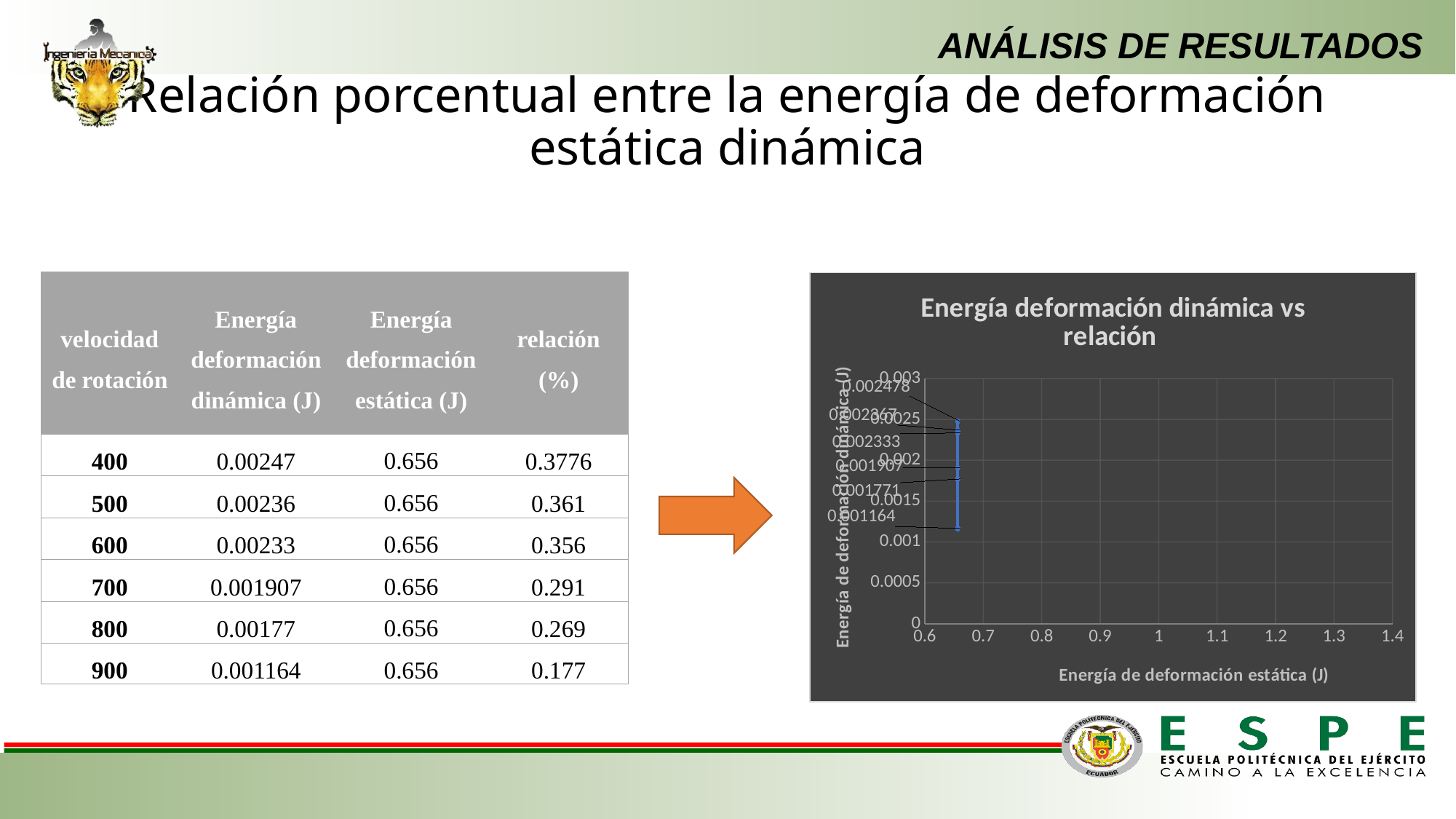
What is the minimum value shown on the chart's x axis? 0.6 What is the difference between the highest and lowest data label values on the chart? 0.001314 Is the highest plotted value on the chart greater or less than 0.002? greater What is the title of the chart on the slide? Energía deformación dinámica vs relación What is the highest data label value shown on the chart? 0.002478 How many data points are labelled on the chart? 6 Which is larger on the chart, the data label 0.001907 or the data label 0.001771? 0.001907 What is the maximum value shown on the chart's y axis? 0.003 Is the lowest plotted value on the chart greater or less than 0.0015? less What is the lowest data label value shown on the chart? 0.001164 What kind of chart is shown on the slide? scatter chart What is the title of the x axis of the chart? Energía de deformación estática (J)